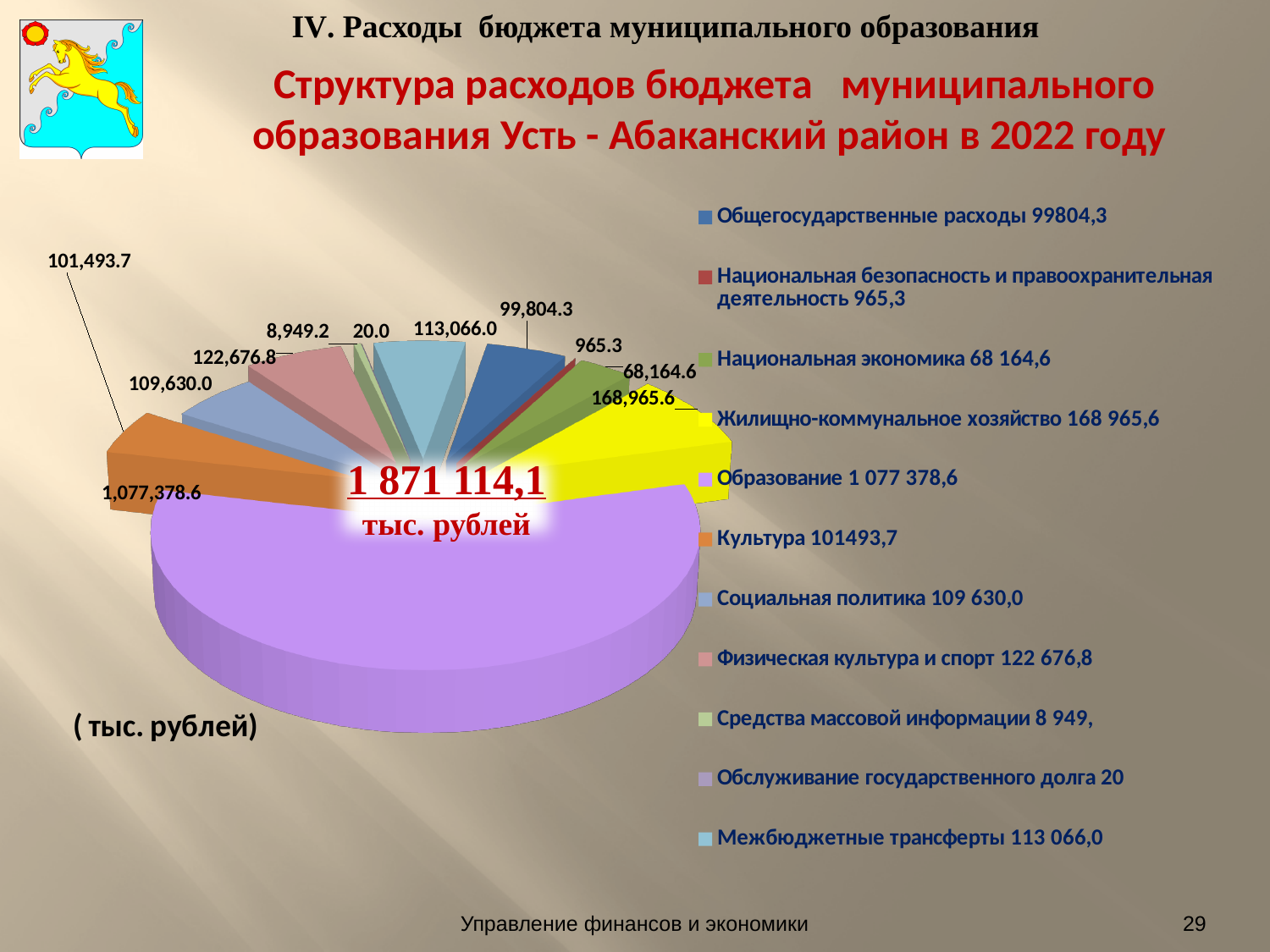
What is the value for Жилищно-коммунальное хозяйство? 168,965.6 What is the difference between the values for Физическая культура и спорт and Социальная политика? 13,046.8 What kind of chart is shown on the slide? pie chart What is the value for Образование in the pie chart? 1,077,378.6 Which is larger: the value for Культура or the value for Общегосударственные расходы? Культура What total amount is printed in the centre of the pie chart? 1 871 114,1 тыс. рублей What is the value for Национальная безопасность и правоохранительная деятельность? 965.3 How many categories does the legend of the pie chart list? 11 What colour is the slice for Жилищно-коммунальное хозяйство? yellow Which category has the largest share of the pie chart? Образование Which category has the smallest value in the pie chart? Обслуживание государственного долга What is the value for Межбюджетные трансферты? 113,066.0